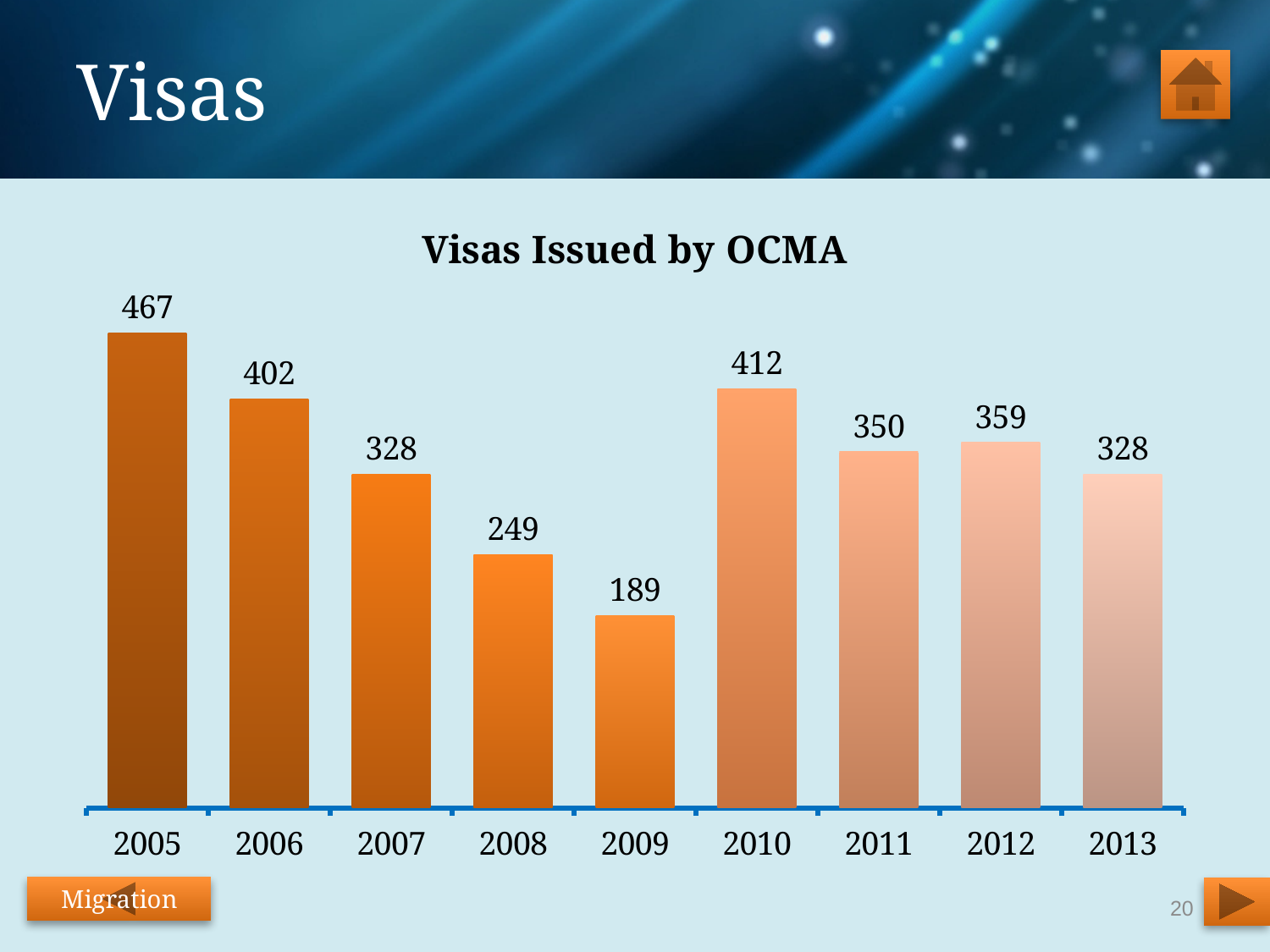
Which year has the lowest number of visas issued? 2009 Which year has a larger value, 2006 or 2010? 2010 What is the difference between the values for 2010 and 2011? 62 Which year has the highest number of visas issued? 2005 Which year has a larger value, 2008 or 2013? 2013 What kind of chart is shown on the slide? Bar chart What is the value shown for 2012? 359 Do the values rise or fall from 2005 to 2009? Fall What is the difference between the values for 2005 and 2009? 278 How many years are shown on the x axis? 9 What is the value shown for 2009? 189 How many visas were issued by OCMA in 2005? 467